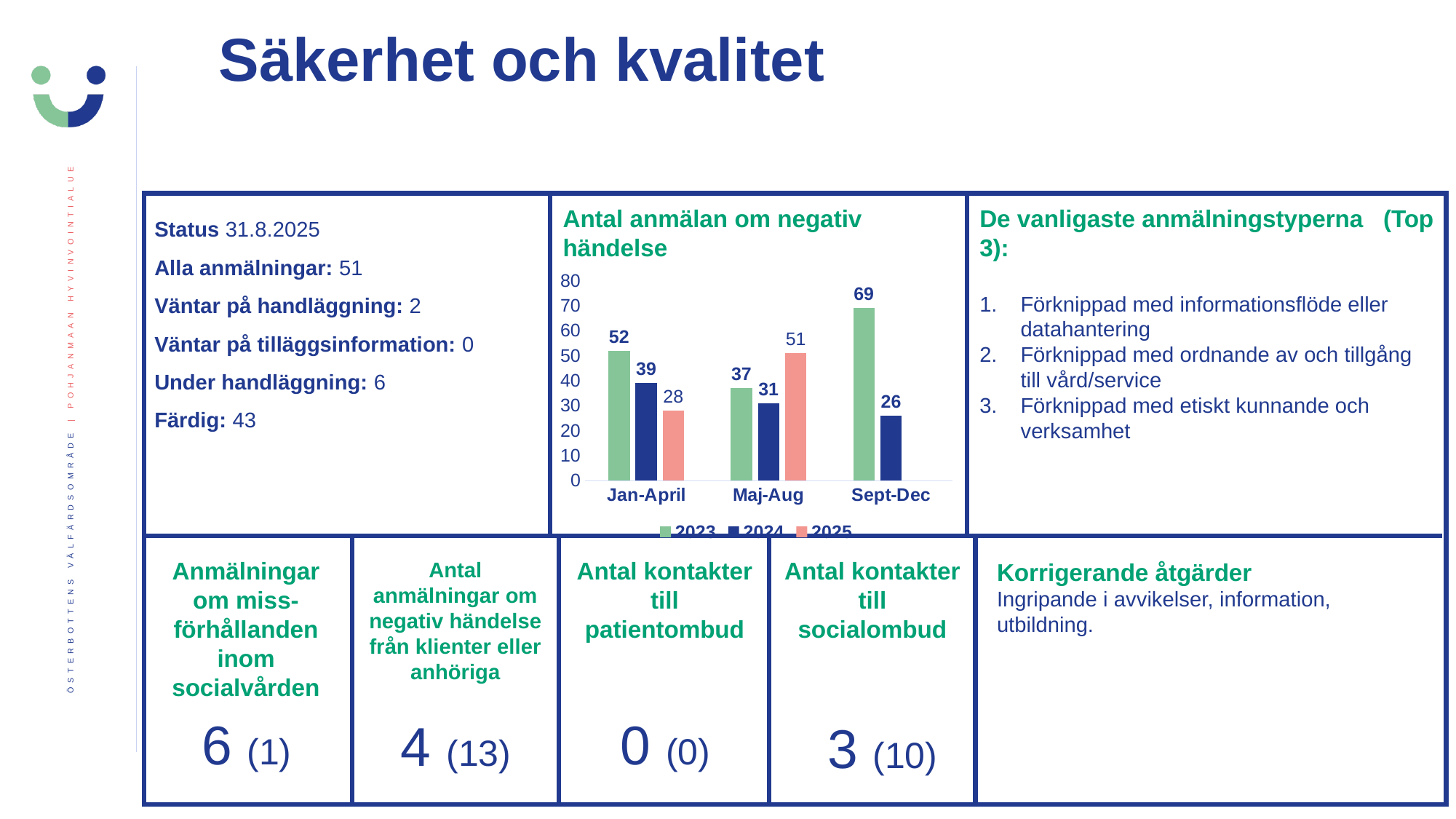
What kind of chart is 'Antal anmälan om negativ händelse'? Bar chart What is the value for 2024 in Sept-Dec in the 'Antal anmälan om negativ händelse' chart? 26 In the 'Antal anmälan om negativ händelse' chart, which is larger for Maj-Aug: the 2023 value or the 2025 value? 2025 In the 'Antal anmälan om negativ händelse' chart, what is the difference between the 2023 and 2024 values for Jan-April? 13 How many series does the legend of the 'Antal anmälan om negativ händelse' chart list? 3 In the 'Antal anmälan om negativ händelse' chart, which period has the lowest value for 2024? Sept-Dec In the 'Antal anmälan om negativ händelse' chart, which period has the highest value for 2023? Sept-Dec In the 'Antal anmälan om negativ händelse' chart, do the 2024 values rise or fall from Jan-April to Sept-Dec? Fall How many periods are shown on the x axis of the 'Antal anmälan om negativ händelse' chart? 3 What is the value for 2025 in Maj-Aug in the 'Antal anmälan om negativ händelse' chart? 51 In the 'Antal anmälan om negativ händelse' chart, is the 2023 value for Sept-Dec greater or less than 60? greater What is the value for 2023 in Jan-April in the 'Antal anmälan om negativ händelse' chart? 52